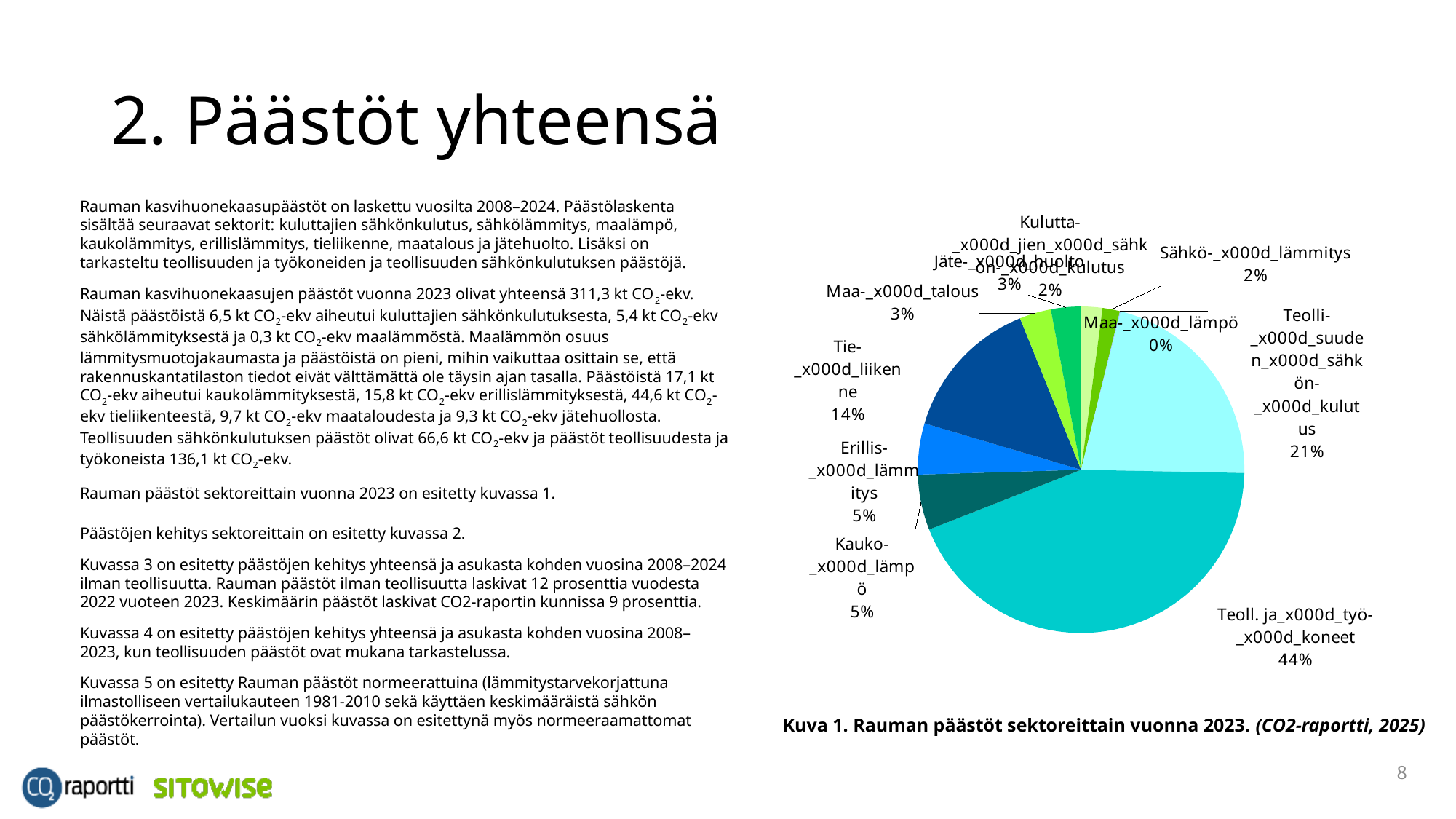
What percentage is shown for 'Maalämpö'? 0% Which sector has the smallest slice of the pie? Maalämpö Which is larger, the 'Tieliikenne' slice or the 'Maatalous' slice? Tieliikenne What share of the pie does the 'Teoll. ja työkoneet' slice have? 44% Which sector has the largest slice of the pie? Teoll. ja työkoneet What is the caption of the chart? Kuva 1. Rauman päästöt sektoreittain vuonna 2023. (CO2-raportti, 2025) What share of the pie does the 'Tieliikenne' slice have? 14% What share of the pie does the 'Teollisuuden sähkön kulutus' slice have? 21% What is the difference in percentage points between 'Teoll. ja työkoneet' and 'Teollisuuden sähkön kulutus'? 23 What kind of chart is shown on the slide? pie chart How many slices does the pie chart have? 10 What percentage is shown for 'Kaukolämpö'? 5%